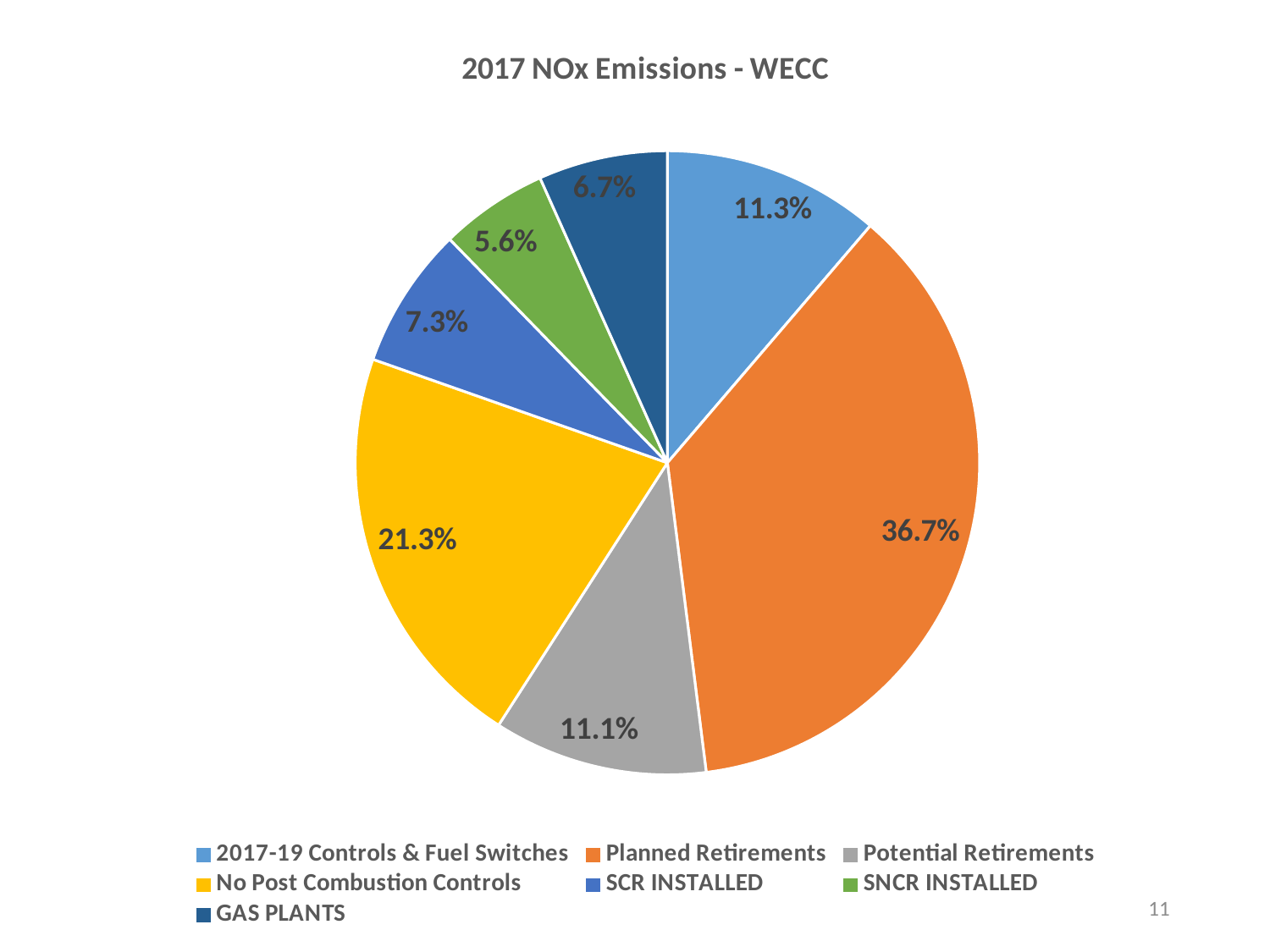
What is the title of the chart? 2017 NOx Emissions - WECC What is the difference in percentage points between Planned Retirements and No Post Combustion Controls? 15.4 What percentage of the pie is No Post Combustion Controls? 21.3% What share of 2017 NOx emissions is attributed to Planned Retirements? 36.7% Which is larger, the share for SCR INSTALLED or the share for GAS PLANTS? SCR INSTALLED What is the value shown for SCR INSTALLED? 7.3% Which category is shown in orange? Planned Retirements What is the value shown for GAS PLANTS? 6.7% Which category has the smallest share of the pie? SNCR INSTALLED What type of chart is shown on the slide? pie chart Which category has the largest share of the pie? Planned Retirements How many categories does the pie chart have? 7